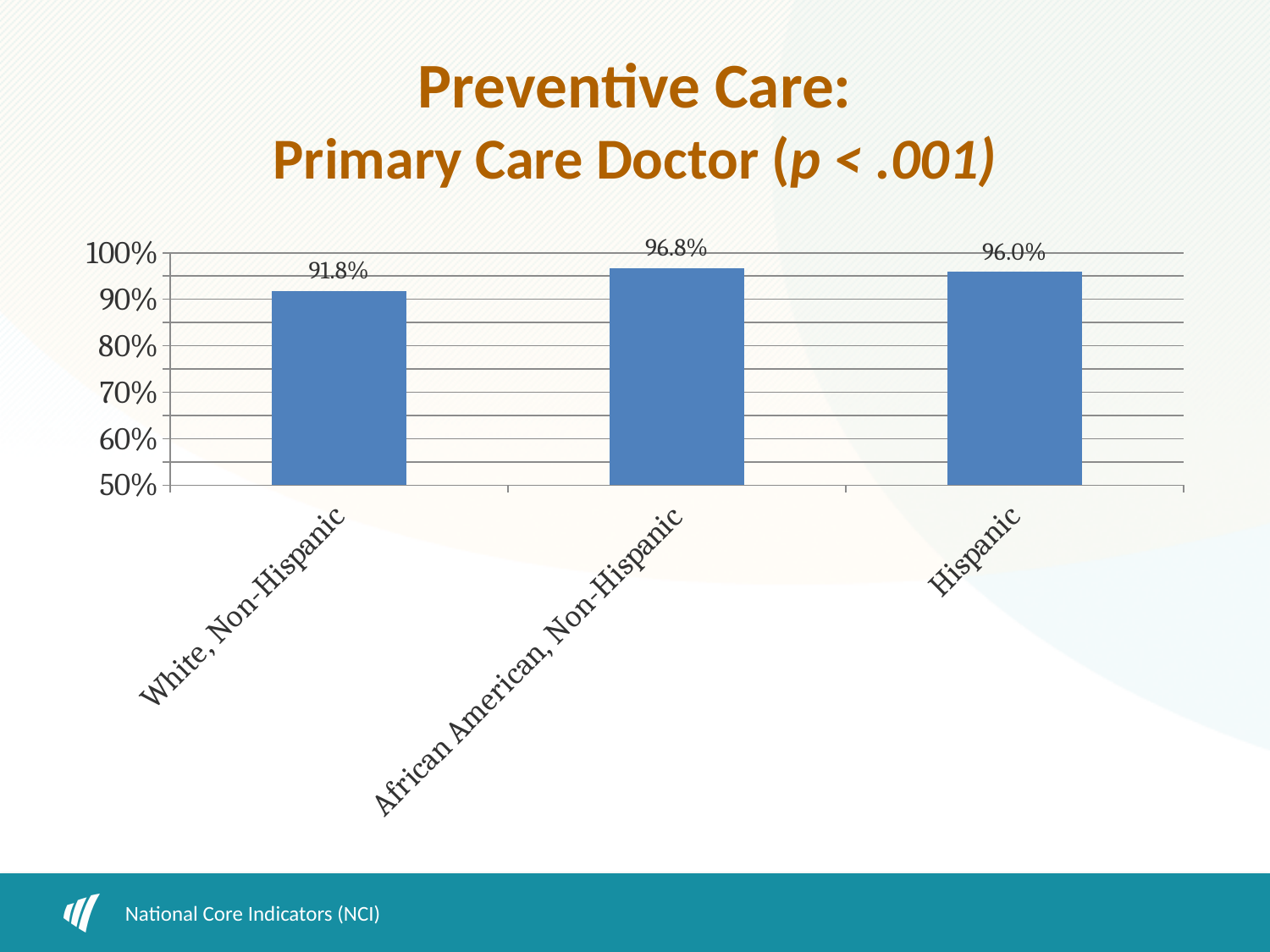
Which category has the lowest value? White, Non-Hispanic Is the value for White, Non-Hispanic greater or less than 90%? greater Which category has the highest value? African American, Non-Hispanic Which is larger, the value for Hispanic or the value for White, Non-Hispanic? Hispanic What is the difference between the values for African American, Non-Hispanic and White, Non-Hispanic? 5.0% What is the difference between the values for Hispanic and White, Non-Hispanic? 4.2% What kind of chart is shown on the slide? bar chart What is the value for White, Non-Hispanic? 91.8% What is the value for African American, Non-Hispanic? 96.8% How many categories are shown on the x axis? 3 What is the value for Hispanic? 96.0% What is the title of the slide? Preventive Care: Primary Care Doctor (p < .001)